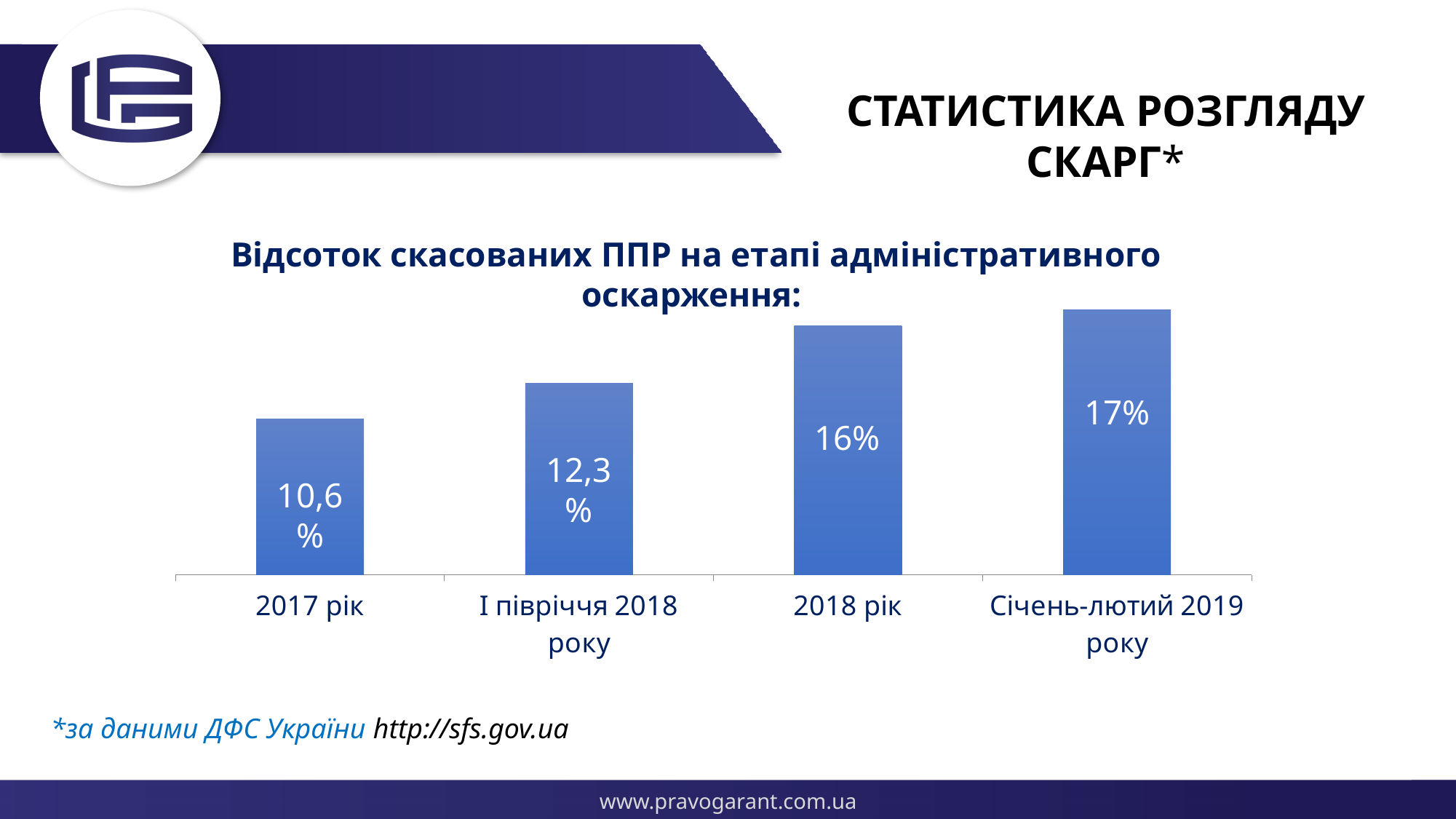
Which category has the lowest value? 2017 рік How many categories are shown on the x axis? 4 What is the difference between the values for 2018 рік and 2017 рік? 5,4% What is the value for Січень-лютий 2019 року? 17% Which category has the highest value? Січень-лютий 2019 року Which is larger, the value for І півріччя 2018 року or the value for 2018 рік? 2018 рік What is the value for 2018 рік? 16% What kind of chart is shown on the slide? Bar chart What is the value for 2017 рік? 10,6% What is the title of the chart? Відсоток скасованих ППР на етапі адміністративного оскарження: Do the values rise or fall from left to right along the x axis? Rise What is the value for І півріччя 2018 року? 12,3%